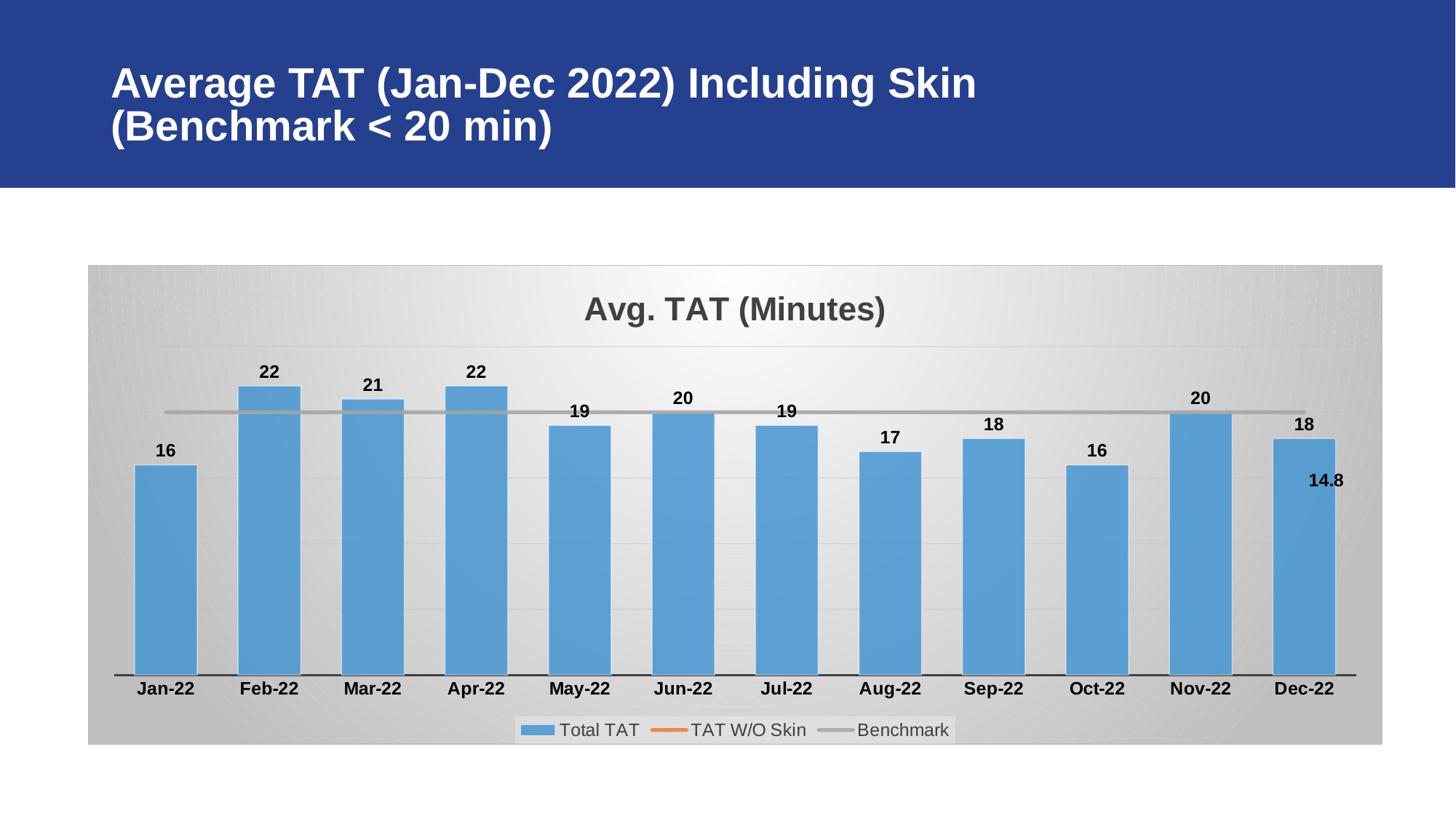
What kind of chart is shown on the slide? Combination bar and line chart How many series does the legend list? 3 What is the Total TAT value for Aug-22? 17 What is the difference between the Total TAT values for Apr-22 and May-22? 3 What is the Total TAT value for Nov-22? 20 How many months are shown on the x axis? 12 What is the Total TAT value for Jan-22? 16 What is the title of the chart? Avg. TAT (Minutes) Which months have the lowest Total TAT value? Jan-22 and Oct-22 Which has a larger Total TAT value, Mar-22 or Sep-22? Mar-22 Which months have the highest Total TAT value? Feb-22 and Apr-22 What is the Total TAT value for Feb-22? 22